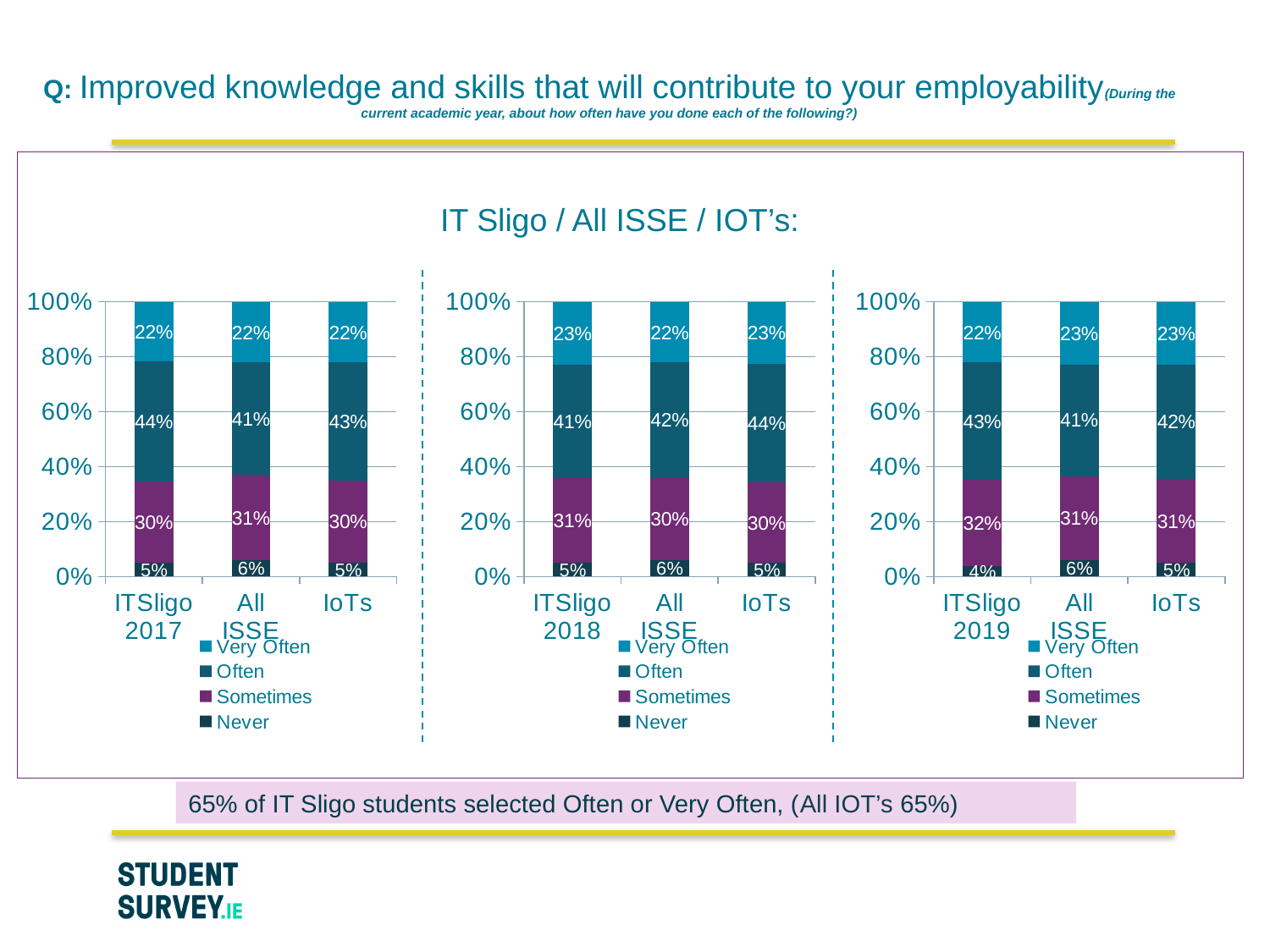
In the middle chart (2018), what is the combined Often and Very Often share for ITSligo 2018? 64% How many categories are shown on the x axis of the left chart (2017)? 3 In the right chart (2019), what percentage of All ISSE students selected Sometimes? 31% How many series does the legend of each chart list? 4 In the middle chart (2018), which category has the lowest Often value? ITSligo 2018 In the left chart (2017), what is the difference between the Often values for ITSligo 2017 and All ISSE? 3% In the right chart (2019), which is larger: the Sometimes value for ITSligo 2019 or for IoTs? ITSligo 2019 What type of chart is used on this slide? Stacked bar chart In the left chart (2017), what percentage of ITSligo 2017 students selected Often? 44% In the right chart (2019), what percentage of ITSligo 2019 students selected Never? 4% In the middle chart (2018), what percentage of IoTs students selected Often? 44% In the left chart (2017), which category has the highest Often value? ITSligo 2017